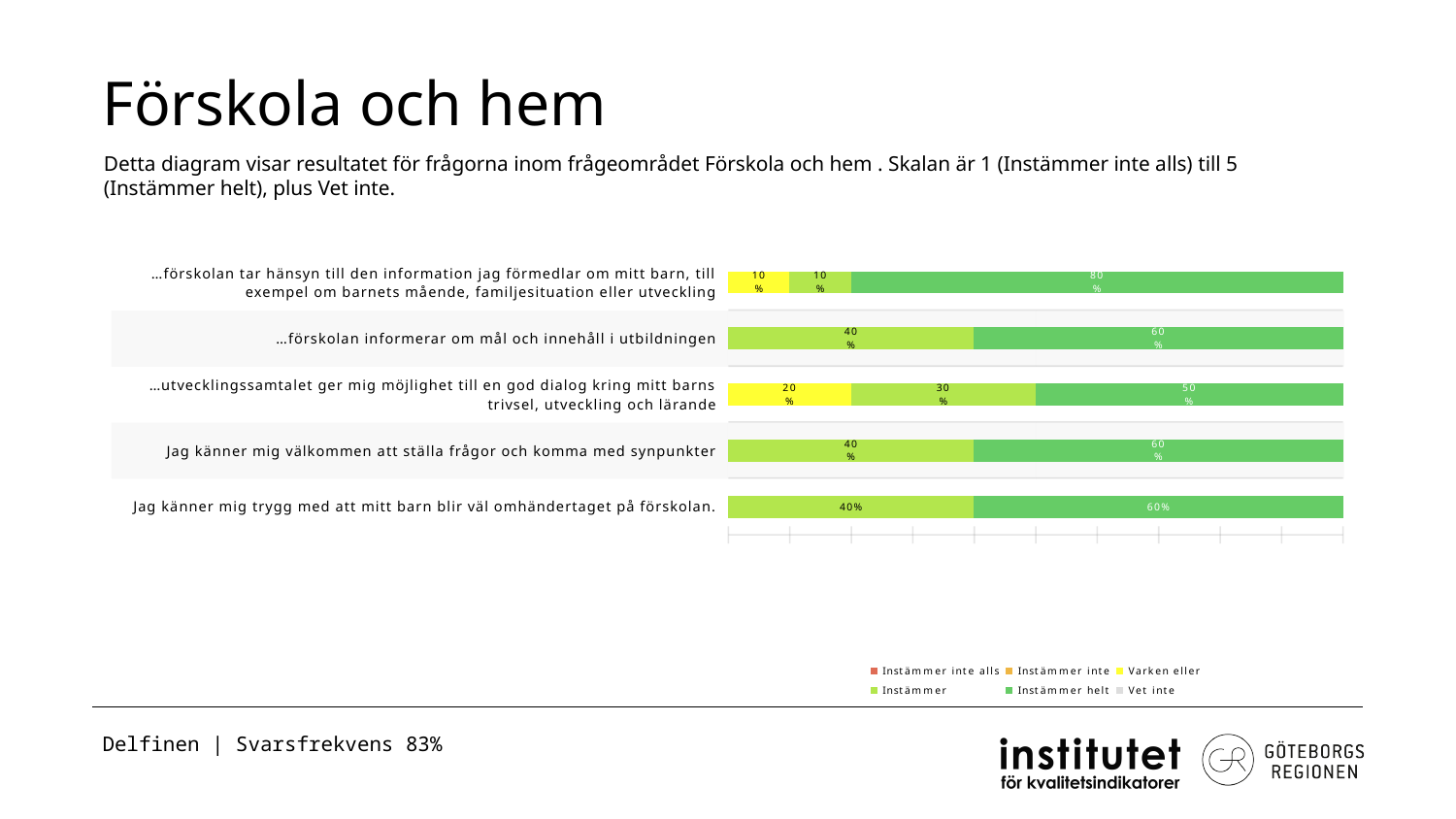
What is the difference between the 'Instämmer helt' value for '…förskolan tar hänsyn till den information jag förmedlar om mitt barn…' and the 'Instämmer helt' value for '…utvecklingssamtalet ger mig möjlighet till en god dialog…'? 30% Which category has the lowest 'Instämmer helt' value? …utvecklingssamtalet ger mig möjlighet till en god dialog kring mitt barns trivsel, utveckling och lärande What is the total of the 'Instämmer' and 'Instämmer helt' values for 'Jag känner mig välkommen att ställa frågor och komma med synpunkter'? 100% What is the 'Instämmer' value for 'Jag känner mig trygg med att mitt barn blir väl omhändertaget på förskolan.'? 40% What is the 'Instämmer helt' value for '…förskolan tar hänsyn till den information jag förmedlar om mitt barn, till exempel om barnets mående, familjesituation eller utveckling'? 80% What is the 'Varken eller' value for '…utvecklingssamtalet ger mig möjlighet till en god dialog kring mitt barns trivsel, utveckling och lärande'? 20% Which category has the highest 'Instämmer helt' value? …förskolan tar hänsyn till den information jag förmedlar om mitt barn, till exempel om barnets mående, familjesituation eller utveckling How many categories (questions) are plotted in the chart? 5 Which is larger for '…utvecklingssamtalet ger mig möjlighet till en god dialog kring mitt barns trivsel, utveckling och lärande': the 'Instämmer' value or the 'Instämmer helt' value? Instämmer helt What is the 'Instämmer helt' value for '…förskolan informerar om mål och innehåll i utbildningen'? 60% What kind of chart is shown on the slide? stacked bar chart How many series does the chart legend list? 6